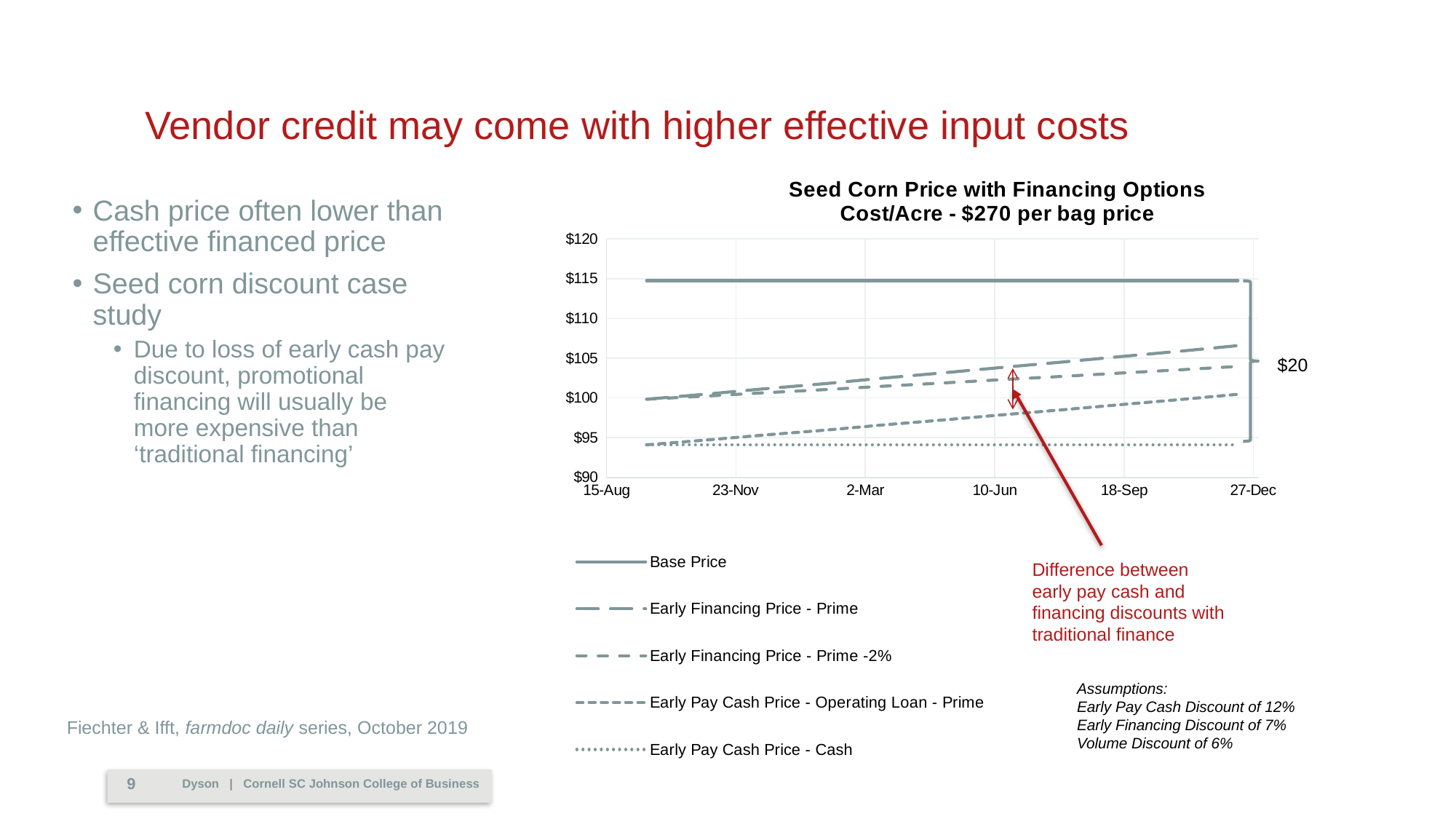
Is the value of the Base Price line greater or less than $110? greater How many series does the legend list? 5 What dollar difference is annotated with the bracket on the right side of the chart? $20 Which series has the highest values across the chart? Base Price Is the value of Early Financing Price - Prime at 27-Dec greater or less than $105? greater Which series has the lowest values across the chart? Early Pay Cash Price - Cash What is the title of the chart? Seed Corn Price with Financing Options Cost/Acre - $270 per bag price Is the value of the Early Pay Cash Price - Cash line greater or less than $100? less At 27-Dec, which is larger: Early Financing Price - Prime or Early Pay Cash Price - Operating Loan - Prime? Early Financing Price - Prime What kind of chart is shown on the slide? line chart Does the Early Financing Price - Prime line rise, fall, or stay flat from 15-Aug to 27-Dec? rise